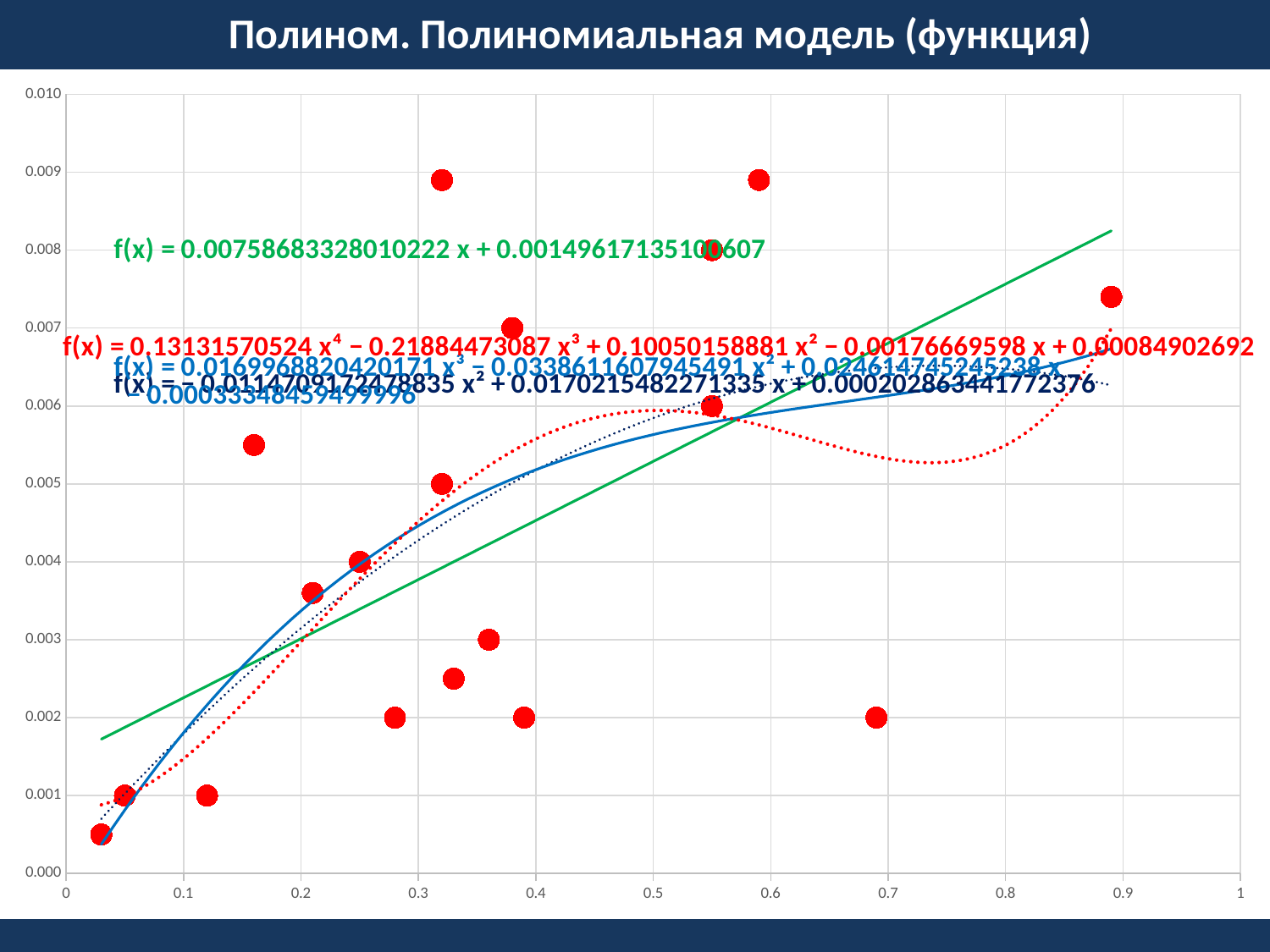
Is the value of the data point at x ≈ 0.12 greater or less than 0.002? less Which data point has the lowest y value: the one at x ≈ 0.03 or the one at x ≈ 0.69? the one at x ≈ 0.03 What is the coefficient of x⁴ in the red polynomial trendline equation? 0.13131570524 Is the value of the data point at x ≈ 0.69 greater or less than 0.003? less Which data point has the higher y value: the one at x ≈ 0.55 near the top or the one at x ≈ 0.89? the one at x ≈ 0.55 What is the maximum value shown on the vertical axis? 0.010 Is the value of the data point at x ≈ 0.16 greater or less than 0.005? greater Does the green straight trendline rise or fall as x increases? rises What is the slope coefficient of x in the green linear trendline equation? 0.00758683328010222 What kind of chart is shown on the slide? scatter chart What is the maximum value shown on the horizontal axis? 1